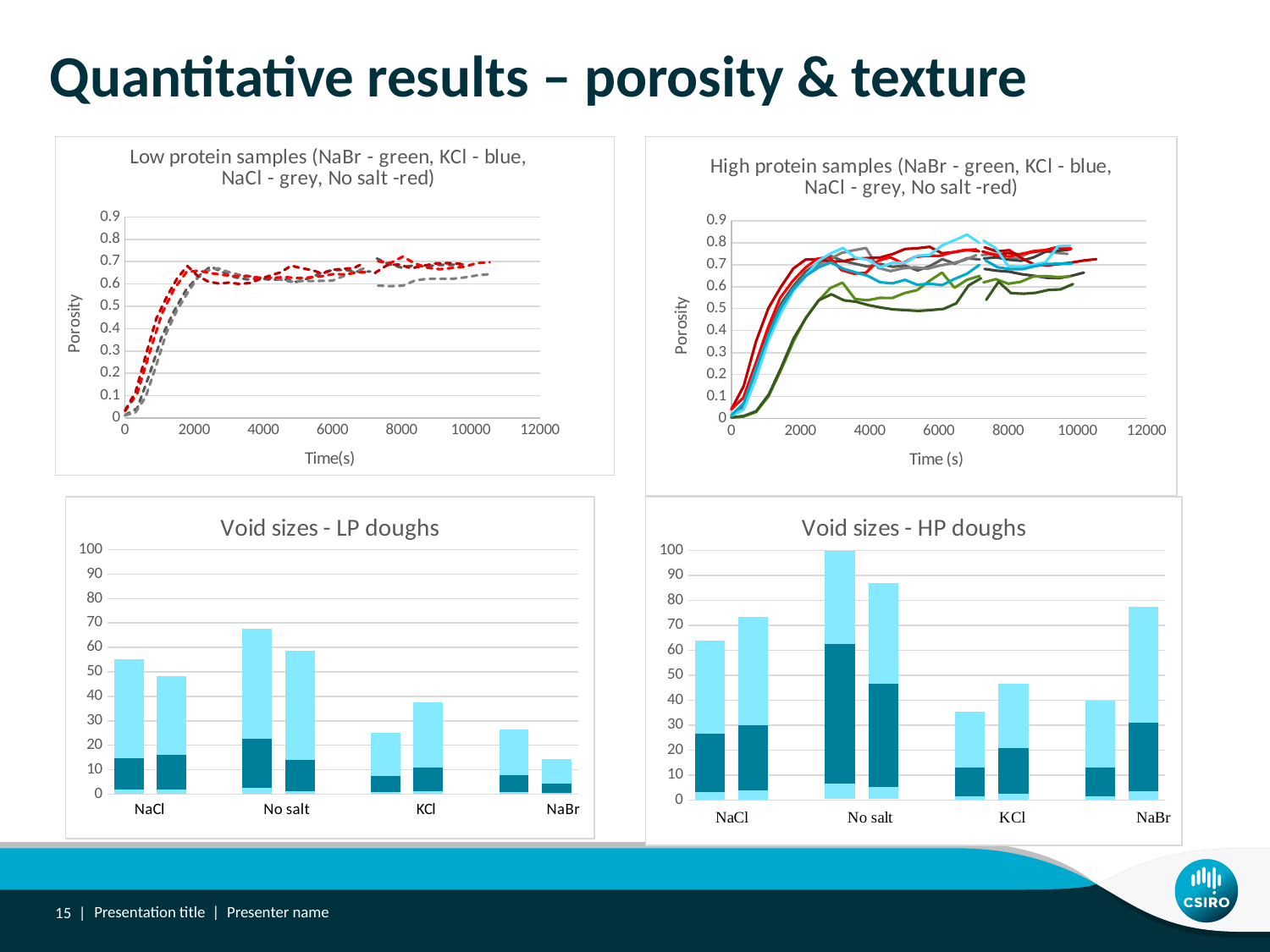
In "Void sizes - HP doughs", is the taller bar for KCl greater or less than 50? less In "Void sizes - HP doughs", how many categories are shown on the x axis? 4 What kind of chart is "Low protein samples (NaBr - green, KCl - blue, NaCl - grey, No salt -red)"? Line chart In the "High protein samples" chart, what is the label on the y axis? Porosity In "Void sizes - LP doughs", which category has the tallest bar? No salt In "Void sizes - LP doughs", which category has the shortest bar? NaBr In "Void sizes - HP doughs", which category has the tallest bar? No salt What kind of chart is "Void sizes - LP doughs"? Bar chart In "Void sizes - LP doughs", are the bars for NaBr greater or less than 30? less In "Void sizes - HP doughs", which has the taller bar, NaBr or KCl? NaBr In "Void sizes - HP doughs", is the tallest bar for No salt greater or less than 90? greater In the "Low protein samples" chart, does porosity rise or fall between 0 and 2000 s? rise